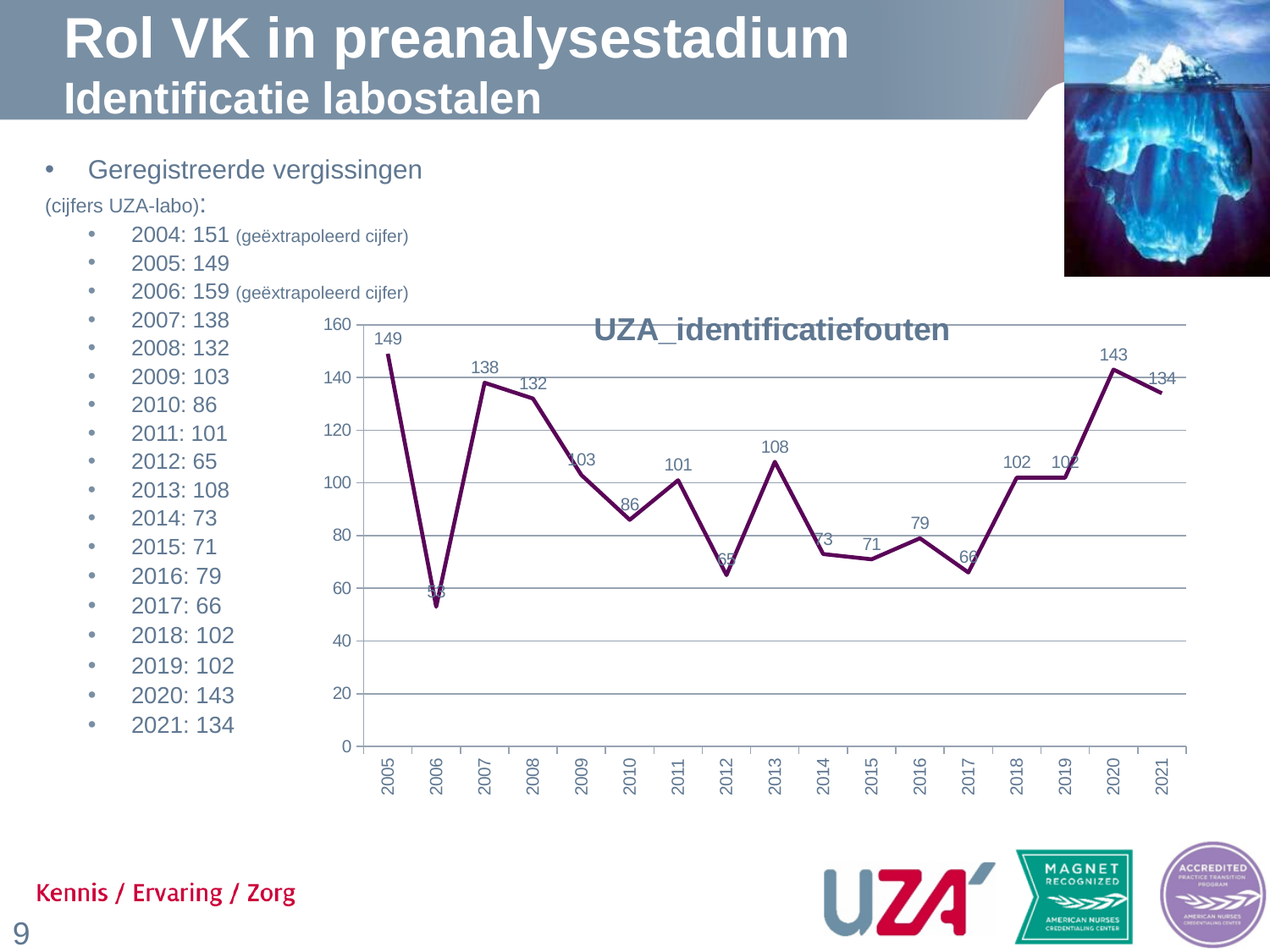
What is the value for 2010 in the chart? 86 What type of chart is shown on the slide? line chart What is the difference between the values for 2020 and 2021? 9 How many years are plotted on the x axis of the chart? 17 Which year has the lowest value in the chart? 2006 Which is larger, the value for 2012 or the value for 2016? 2016 Which year has the highest value in the chart? 2005 What is the title of the chart? UZA_identificatiefouten What is the value for 2020 in the chart? 143 Is the value for 2017 greater or less than 80? less What is the value for 2013 in the chart? 108 What is the value for 2005 in the chart? 149